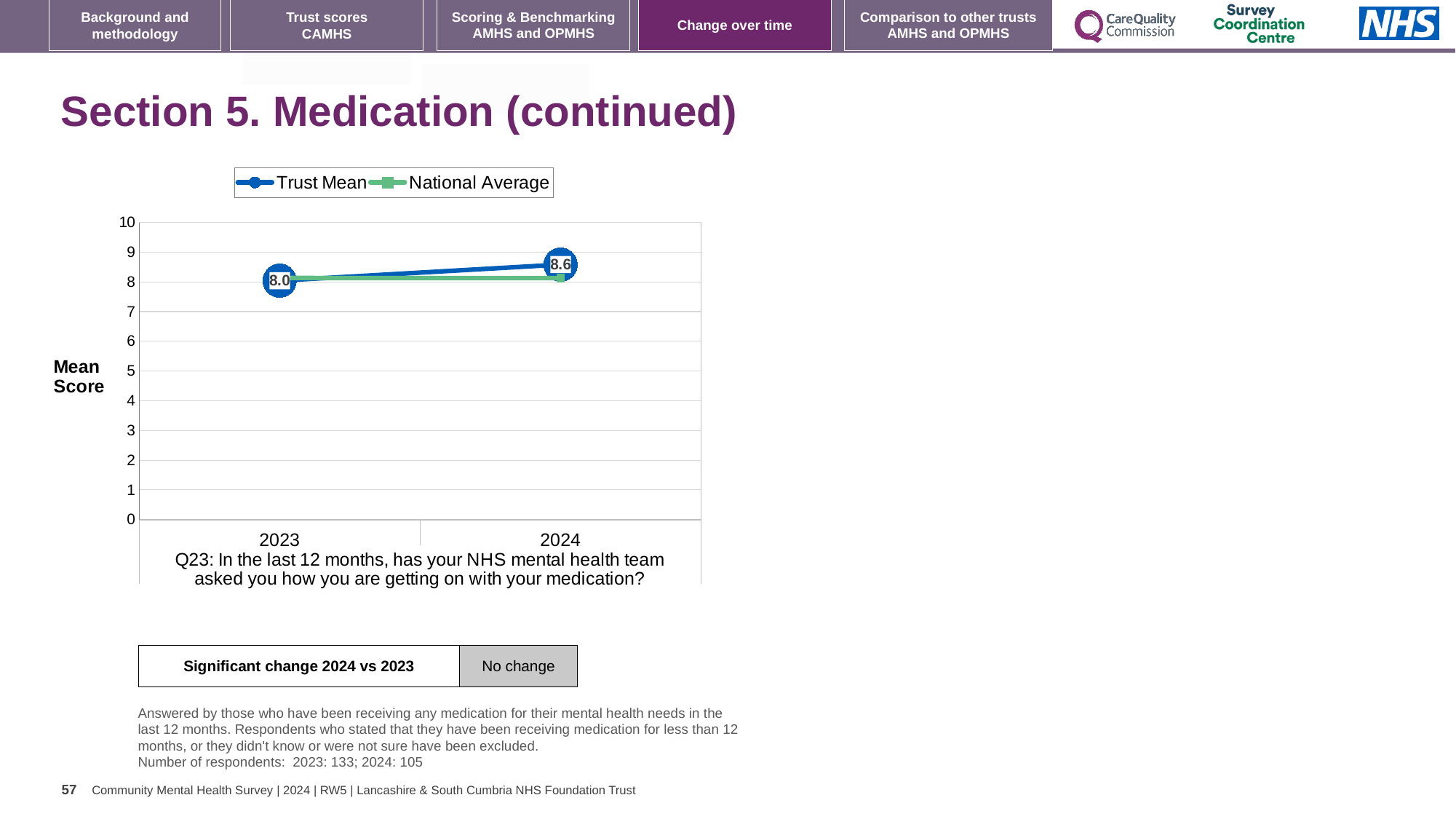
Does the Trust Mean rise or fall from 2023 to 2024? Rise In which year is the Trust Mean highest? 2024 What is the Trust Mean value for 2024? 8.6 What is the label on the y axis of the chart? Mean Score How many years are plotted on the x axis? 2 In which year is the Trust Mean lowest? 2023 What is the Trust Mean value for 2023? 8.0 How many series does the legend list? 2 What kind of chart is shown on the slide? Line chart Is the National Average value for 2024 greater or less than 5? greater Which is larger, the Trust Mean for 2023 or for 2024? 2024 What is the difference between the Trust Mean in 2024 and in 2023? 0.6